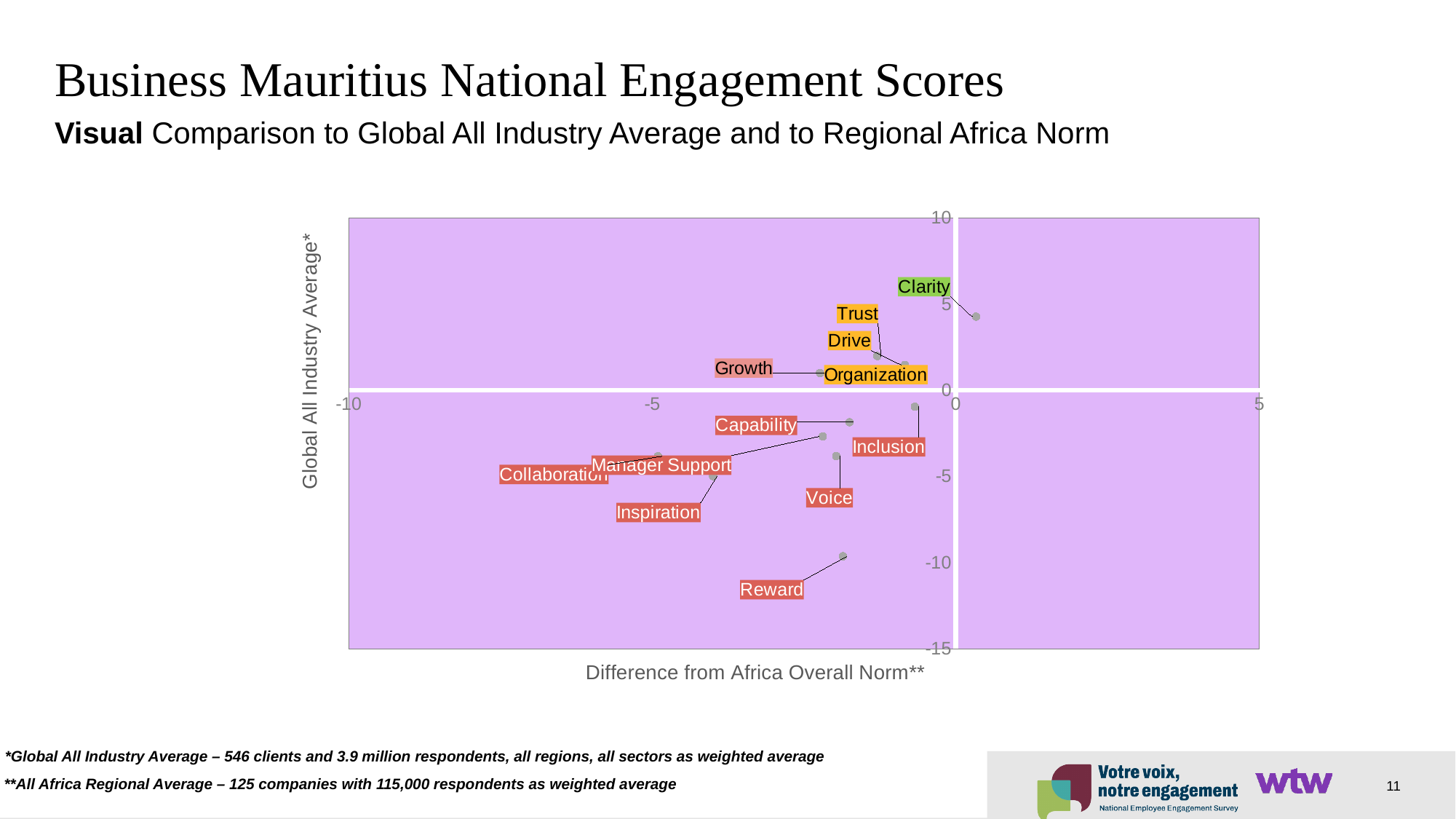
Which labeled point has the highest value on the vertical (Global All Industry Average) axis? Clarity Which data point label is highlighted in green? Clarity What kind of chart is shown on the slide? Scatter chart Is the horizontal-axis value for Collaboration greater or less than -4? less Is the horizontal-axis value for Clarity greater or less than 0? greater How many labeled data points are plotted on the chart? 12 What is the title of the horizontal axis? Difference from Africa Overall Norm** Which has the higher vertical-axis value, Trust or Voice? Trust Is the vertical-axis value for Reward greater or less than -5? less Which has the lower vertical-axis value, Inspiration or Capability? Inspiration Which labeled point has the lowest value on the vertical (Global All Industry Average) axis? Reward Which labeled point is furthest to the left on the horizontal (Difference from Africa Overall Norm) axis? Collaboration